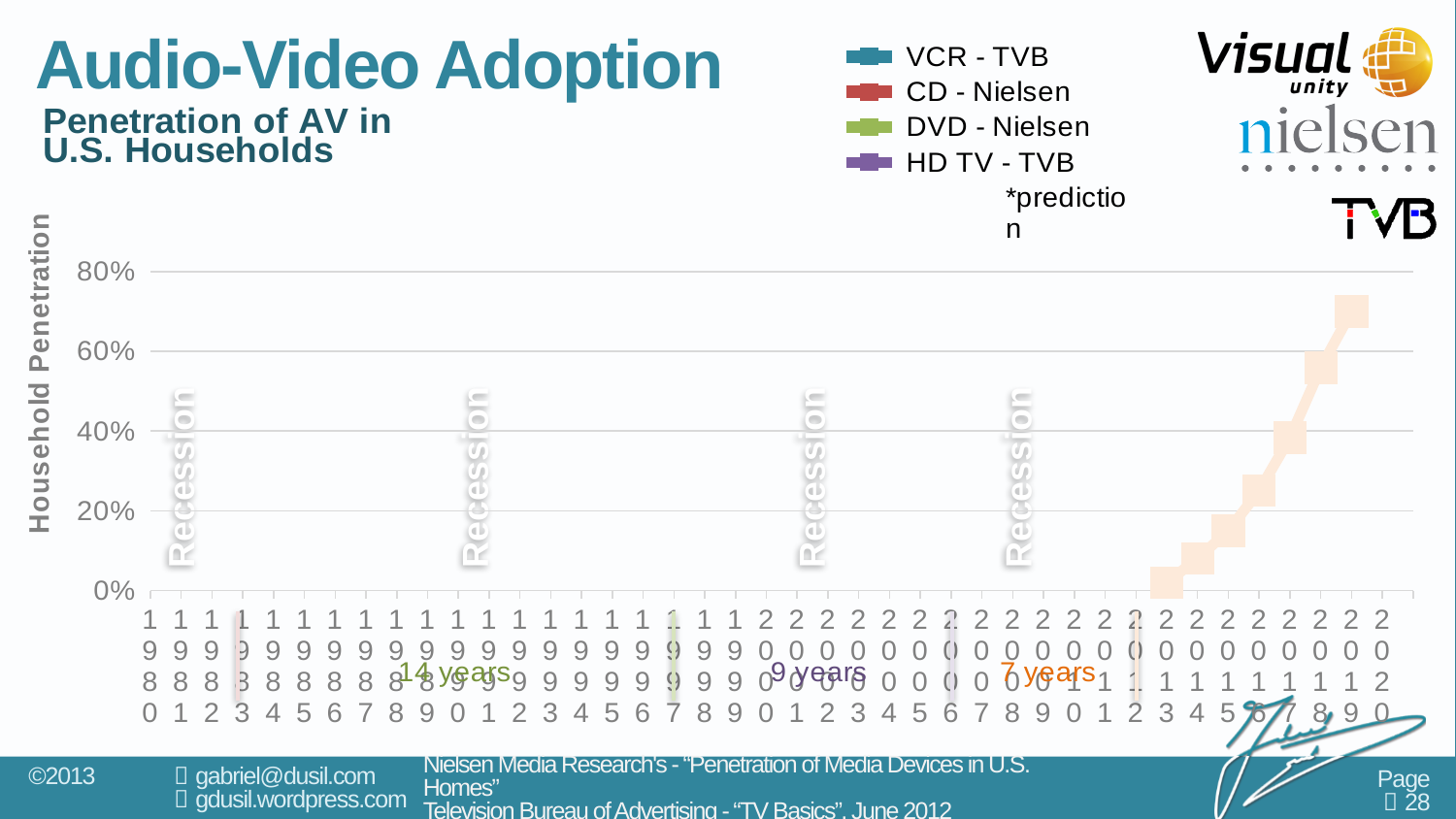
What kind of chart is shown on the slide? line chart How many years are labelled along the x axis? 41 What are the series names listed in the legend? VCR - TVB, CD - Nielsen, DVD - Nielsen, HD TV - TVB Does the plotted line rise or fall as it moves toward the right end of the x axis? rise How many series does the legend list? 4 What is the highest value shown on the vertical axis? 80% What is the title of the vertical axis? Household Penetration